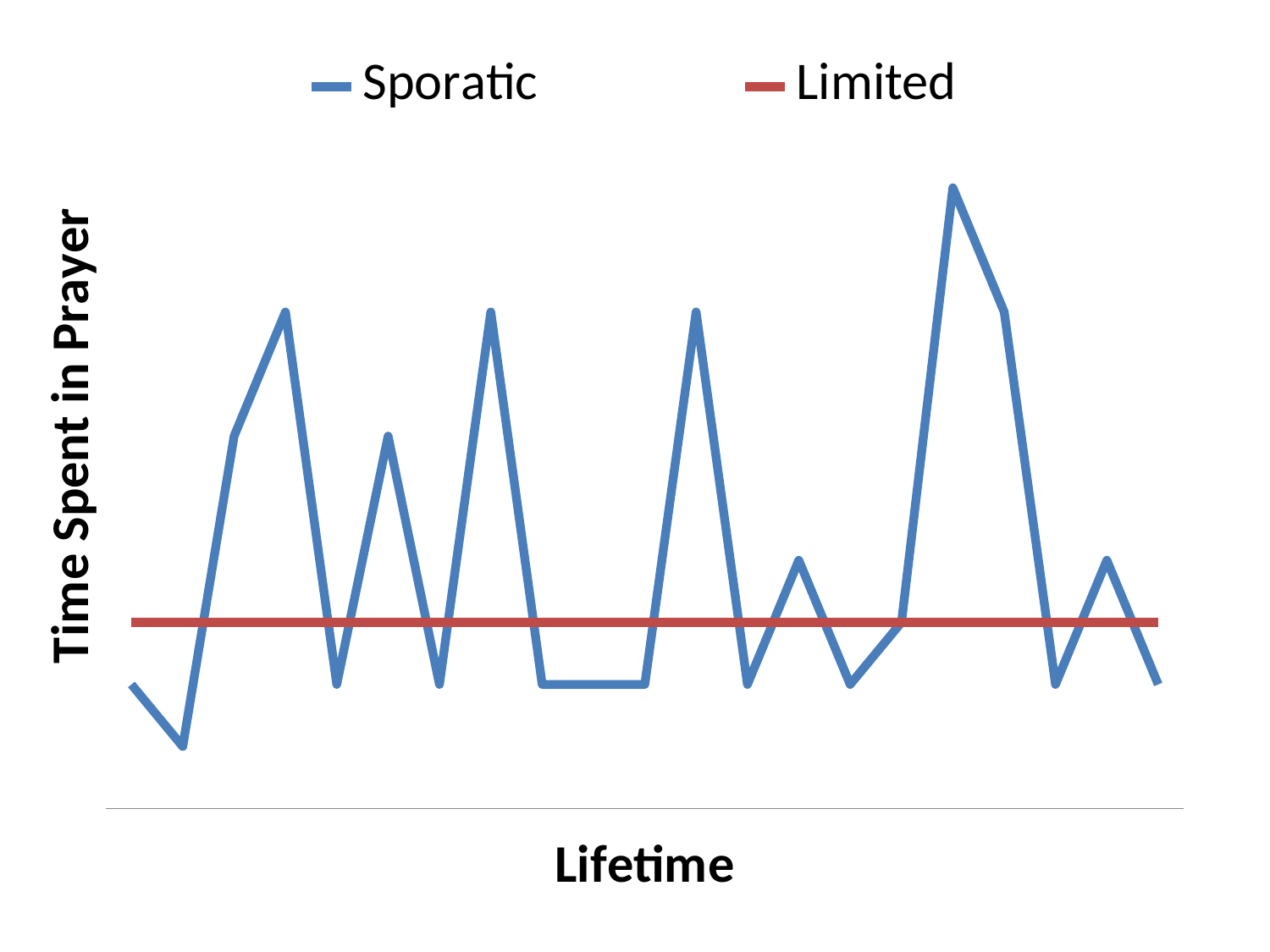
What is the title of the vertical axis? Time Spent in Prayer How many series does the legend list? 2 Which series reaches the higher peak, Sporatic or Limited? Sporatic What are the names of the two series in the legend? Sporatic and Limited Does the Limited series rise, fall, or stay flat across the x axis? stays flat What kind of chart is shown on the slide? line chart